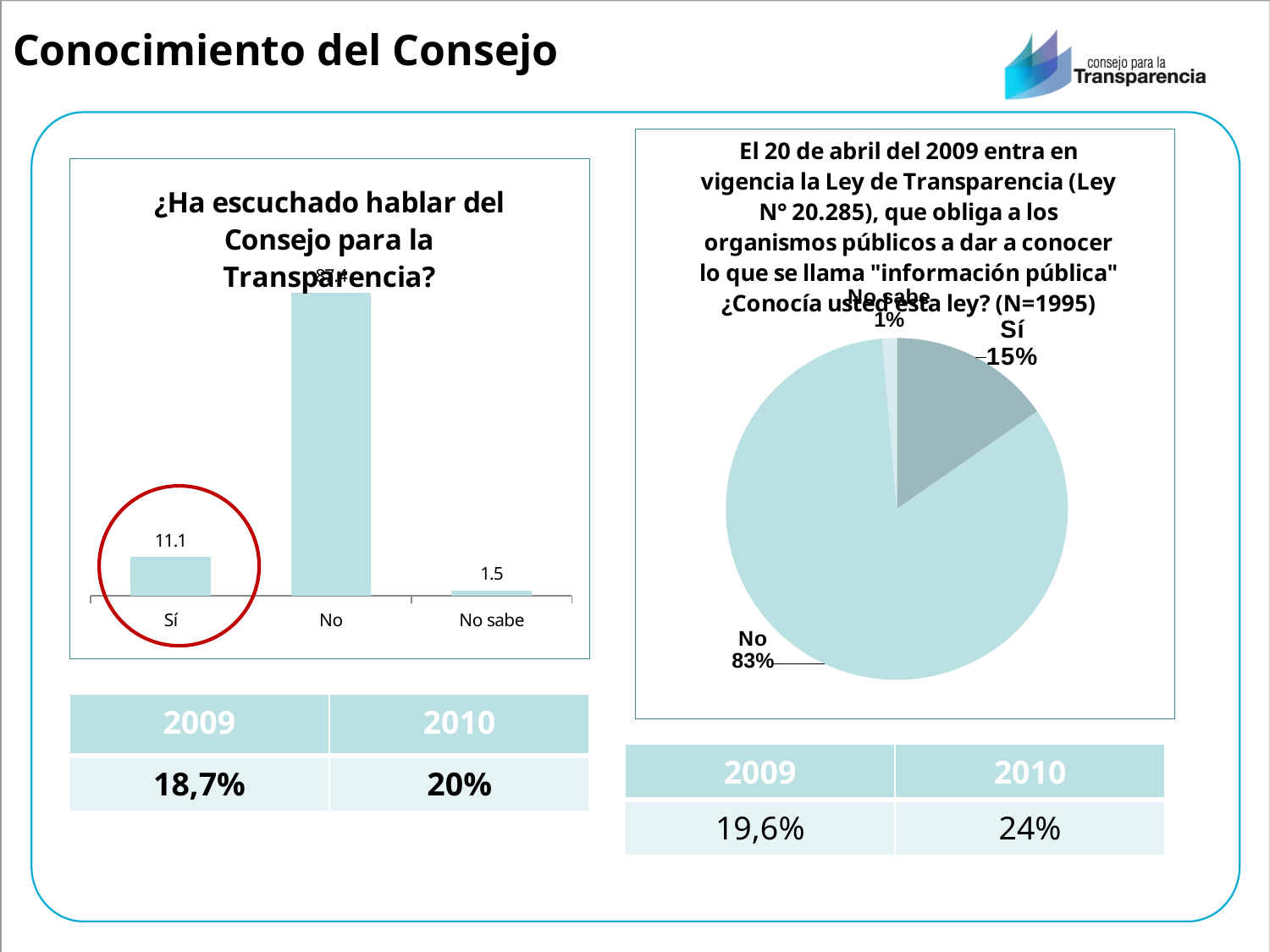
In the bar chart on the left, what is the difference between the values for Sí and No sabe? 9.6 In the bar chart on the left, which category has the lowest value? No sabe In the pie chart on the right, which slice is the largest? No In the pie chart on the right, how many slices are there? 3 In the bar chart on the left, which category has the highest value? No In the pie chart on the right, what share does the No sabe slice have? 1% What kind of chart is the chart on the left of the slide? Bar chart In the bar chart on the left, what is the value for Sí? 11.1 In the pie chart on the right, what share does the No slice have? 83% In the bar chart on the left, what is the value for No sabe? 1.5 In the pie chart on the right, what share does the Sí slice have? 15% In the bar chart on the left, how many categories are shown on the x axis? 3